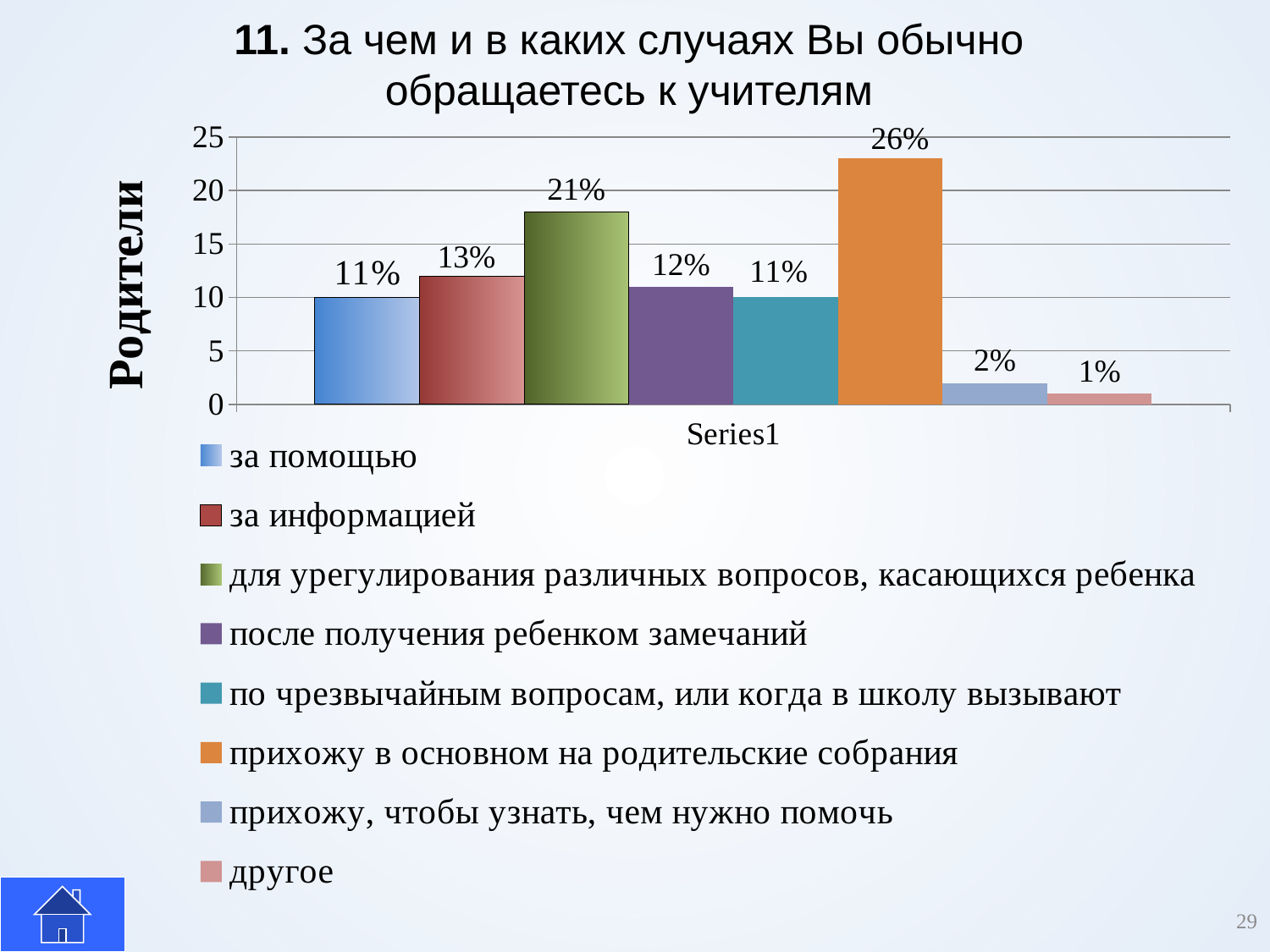
What is the data label on the bar for "за помощью"? 11% What is the label on the vertical axis of the chart? Родители What is the difference between the data labels for "прихожу в основном на родительские собрания" and "для урегулирования различных вопросов, касающихся ребенка"? 5% How many series does the legend list? 8 Which legend entry has the highest bar? прихожу в основном на родительские собрания Which has the larger data label: "за информацией" or "после получения ребенком замечаний"? за информацией What is the data label on the bar for "прихожу, чтобы узнать, чем нужно помочь"? 2% Is the bar for "для урегулирования различных вопросов, касающихся ребенка" greater or less than 15 on the vertical axis? greater Which legend entry has the lowest bar? другое What kind of chart is shown on the slide? bar chart What is the data label on the bar for "для урегулирования различных вопросов, касающихся ребенка"? 21% What is the data label on the bar for "прихожу в основном на родительские собрания"? 26%